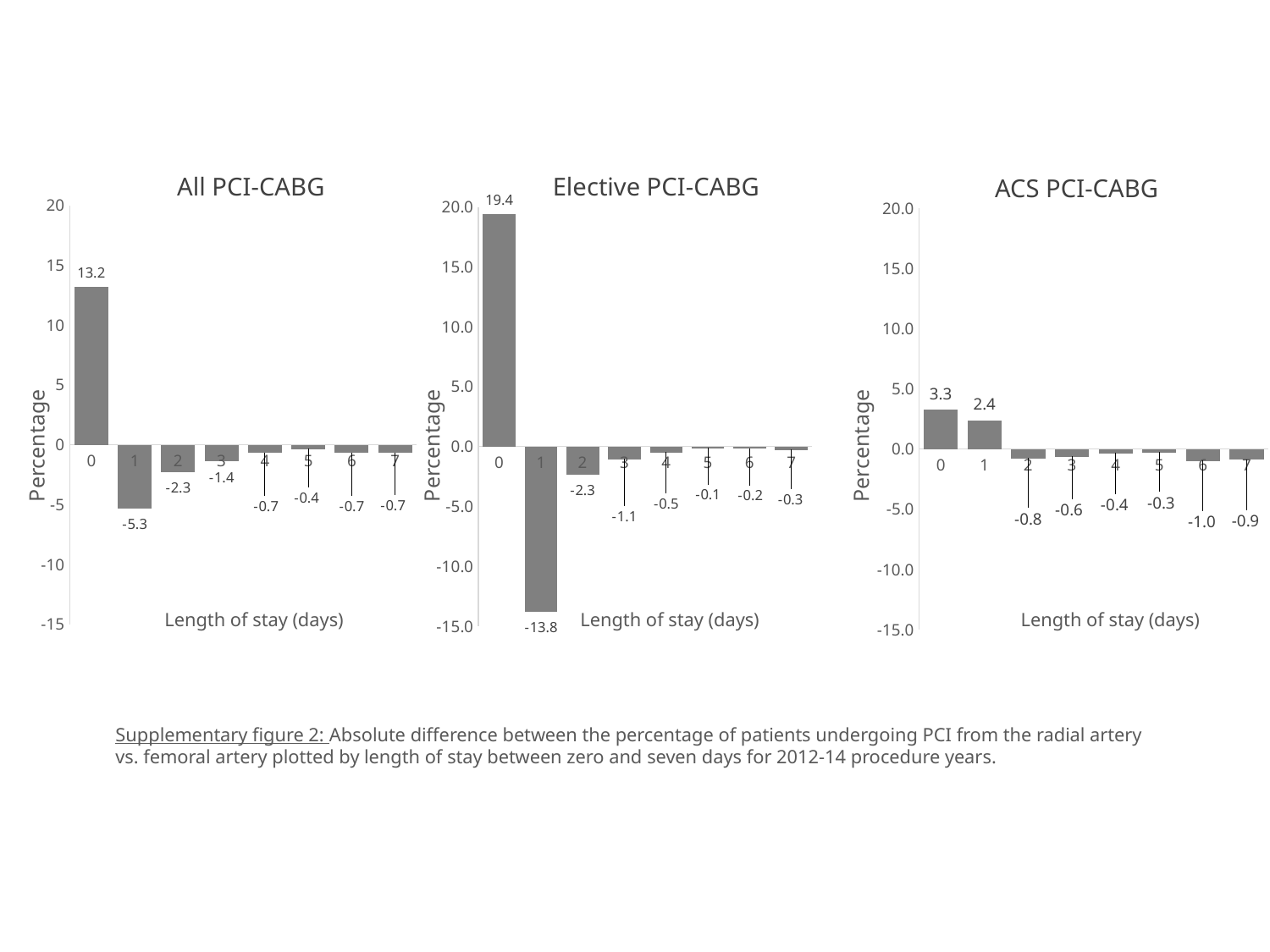
In the All PCI-CABG chart, what is the value for a length of stay of 1 day? -5.3 In the All PCI-CABG chart, what is the difference between the values for 0 days and 1 day? 18.5 In the ACS PCI-CABG chart, which length of stay has the highest value? 0 In the All PCI-CABG chart, what is the value for a length of stay of 0 days? 13.2 In the Elective PCI-CABG chart, which length of stay has the lowest value? 1 In the Elective PCI-CABG chart, is the value for 0 days greater or less than 15.0? greater In the Elective PCI-CABG chart, what is the value for a length of stay of 0 days? 19.4 What kind of chart is the ACS PCI-CABG chart? bar chart In the ACS PCI-CABG chart, which is larger, the value for 6 days or the value for 3 days? 3 days How many length-of-stay categories are plotted in the All PCI-CABG chart? 8 What is the y-axis label on the Elective PCI-CABG chart? Percentage In the ACS PCI-CABG chart, what is the value for a length of stay of 1 day? 2.4